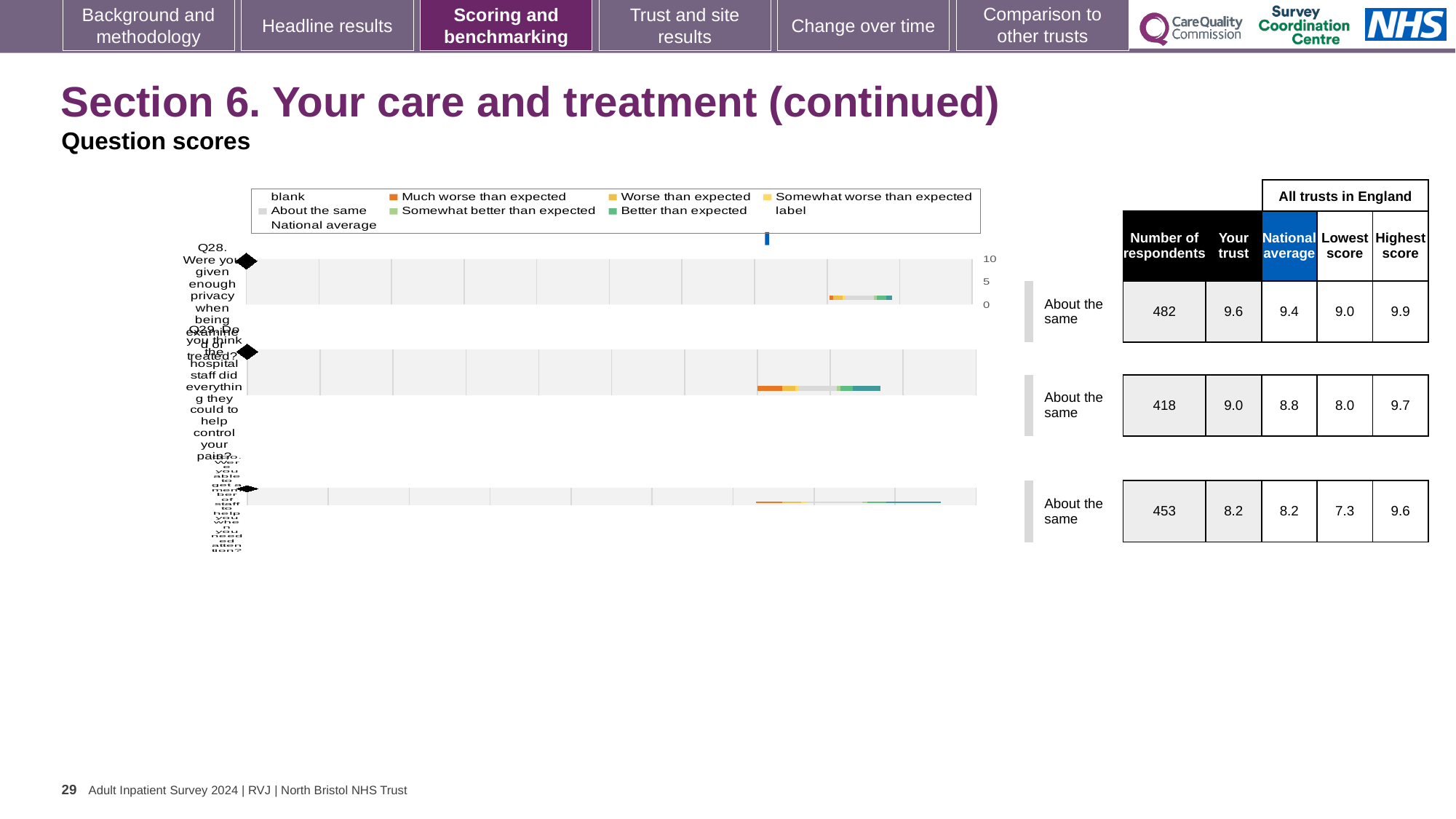
What benchmark category is shown for all three questions on this slide? About the same What is the national average score for Q29 (Do you think the hospital staff did everything they could to help control your pain?)? 8.8 How many questions (Q28, Q29, Q30) are plotted on this slide? 3 What is the lowest score among all trusts in England for Q30? 7.3 What is the difference between the 'Your trust' score and the national average for Q28? 0.2 How many respondents answered Q30 (Were you able to get a member of staff to help you when you needed attention?)? 453 Which of the three questions has the lowest national average score? Q30 What kind of chart is used to show the question scores on this slide? bar chart Is the 'Your trust' score for Q29 higher or lower than the national average for Q29? higher What is the highest score among all trusts in England for Q28? 9.9 What is the 'Your trust' score for Q28 (Were you given enough privacy when being examined or treated?)? 9.6 Which of the three questions has the highest 'Your trust' score? Q28